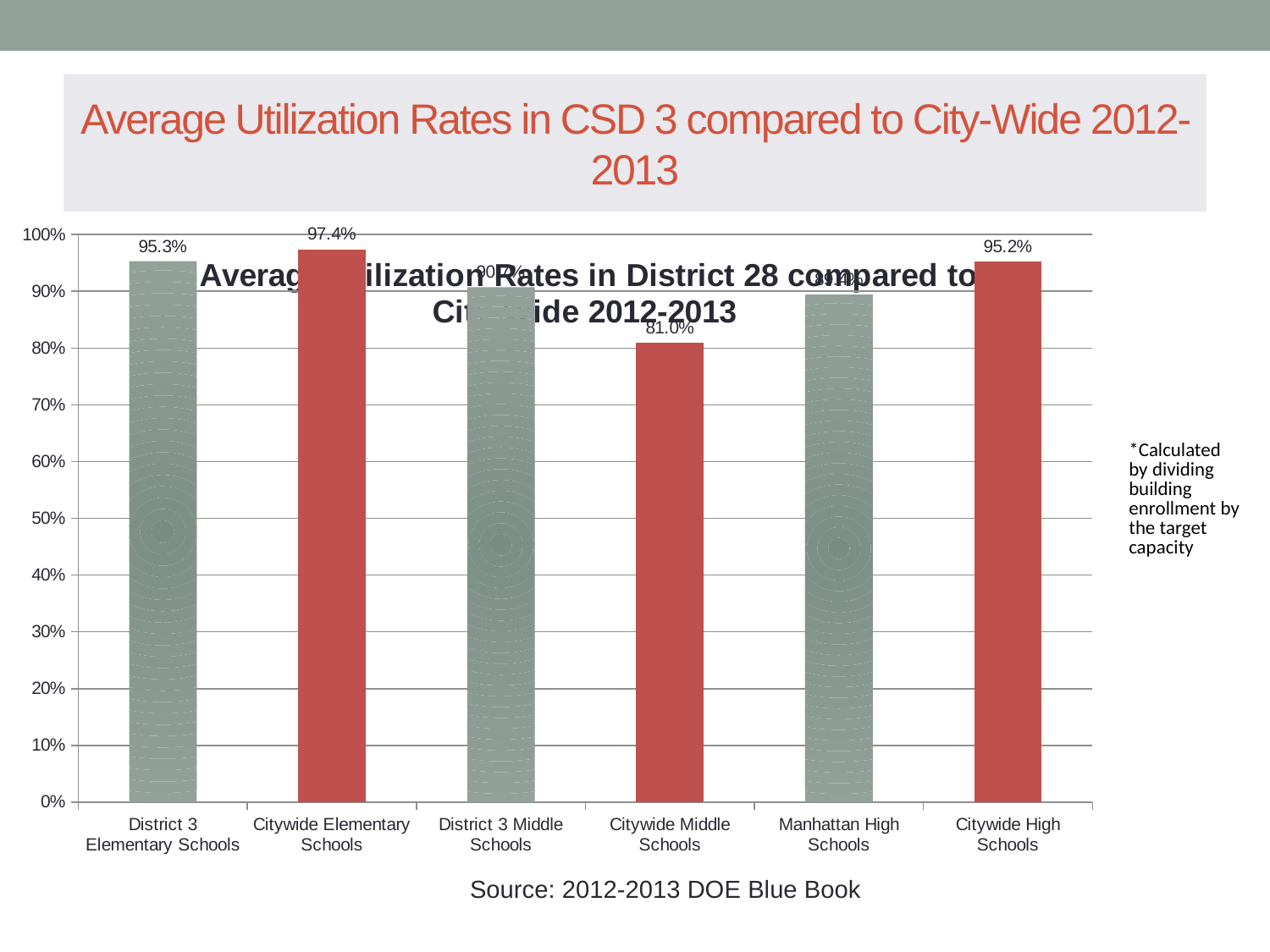
How many categories are shown on the x axis of the chart? 6 What is the average utilization rate for Citywide High Schools? 95.2% Which category has the highest utilization rate? Citywide Elementary Schools Which category has the lowest utilization rate? Citywide Middle Schools What type of chart is shown on the slide? Bar chart What is the difference between the utilization rates of Citywide Elementary Schools and District 3 Elementary Schools? 2.1 percentage points What is the average utilization rate for Citywide Elementary Schools? 97.4% Which has a higher utilization rate, District 3 Elementary Schools or Citywide Elementary Schools? Citywide Elementary Schools What is the difference between the utilization rates of Citywide High Schools and Citywide Middle Schools? 14.2 percentage points What is the average utilization rate for Citywide Middle Schools? 81.0% What is the average utilization rate for District 3 Elementary Schools? 95.3% Is the value for Manhattan High Schools greater or less than 80%? greater